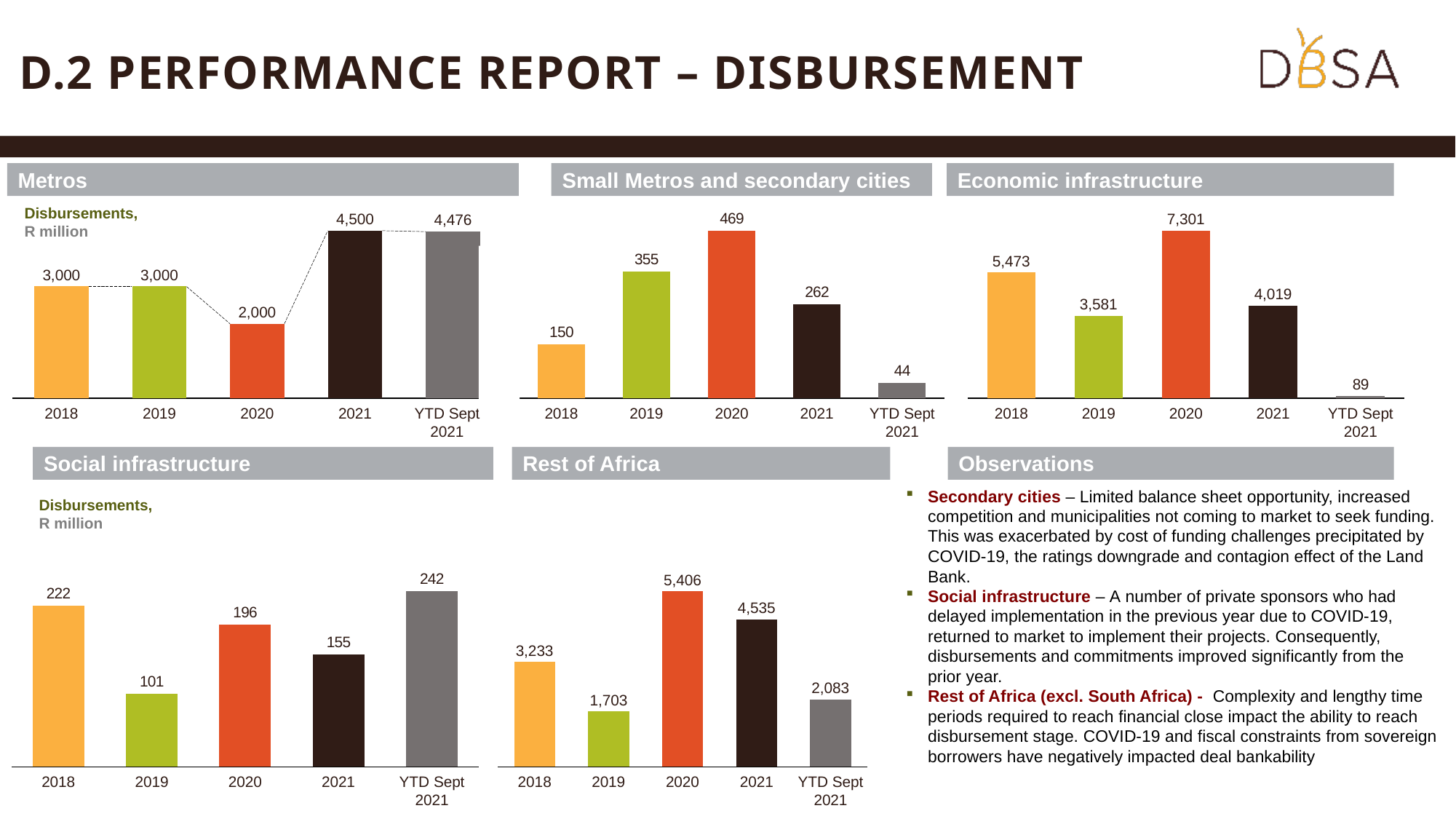
In the Economic infrastructure chart, what is the difference between the 2020 and 2019 values? 3,720 In the Social infrastructure chart, which year has the lowest disbursement? 2019 In the Rest of Africa chart, what is the value for 2019? 1,703 In the Rest of Africa chart, is the value for 2020 or 2021 larger? 2020 In the Metros chart, what is the difference between the 2021 and 2020 values? 2,500 In the Small Metros and secondary cities chart, what is the difference between the 2021 and YTD Sept 2021 values? 218 What unit is stated for the disbursement values in the Metros chart? R million How many bars are plotted in the Metros chart? 5 In the Metros chart, what is the disbursement value for 2021? 4,500 In the Small Metros and secondary cities chart, which year has the highest disbursement? 2020 In the Economic infrastructure chart, what is the value for YTD Sept 2021? 89 What type of chart is the Social infrastructure chart? bar chart